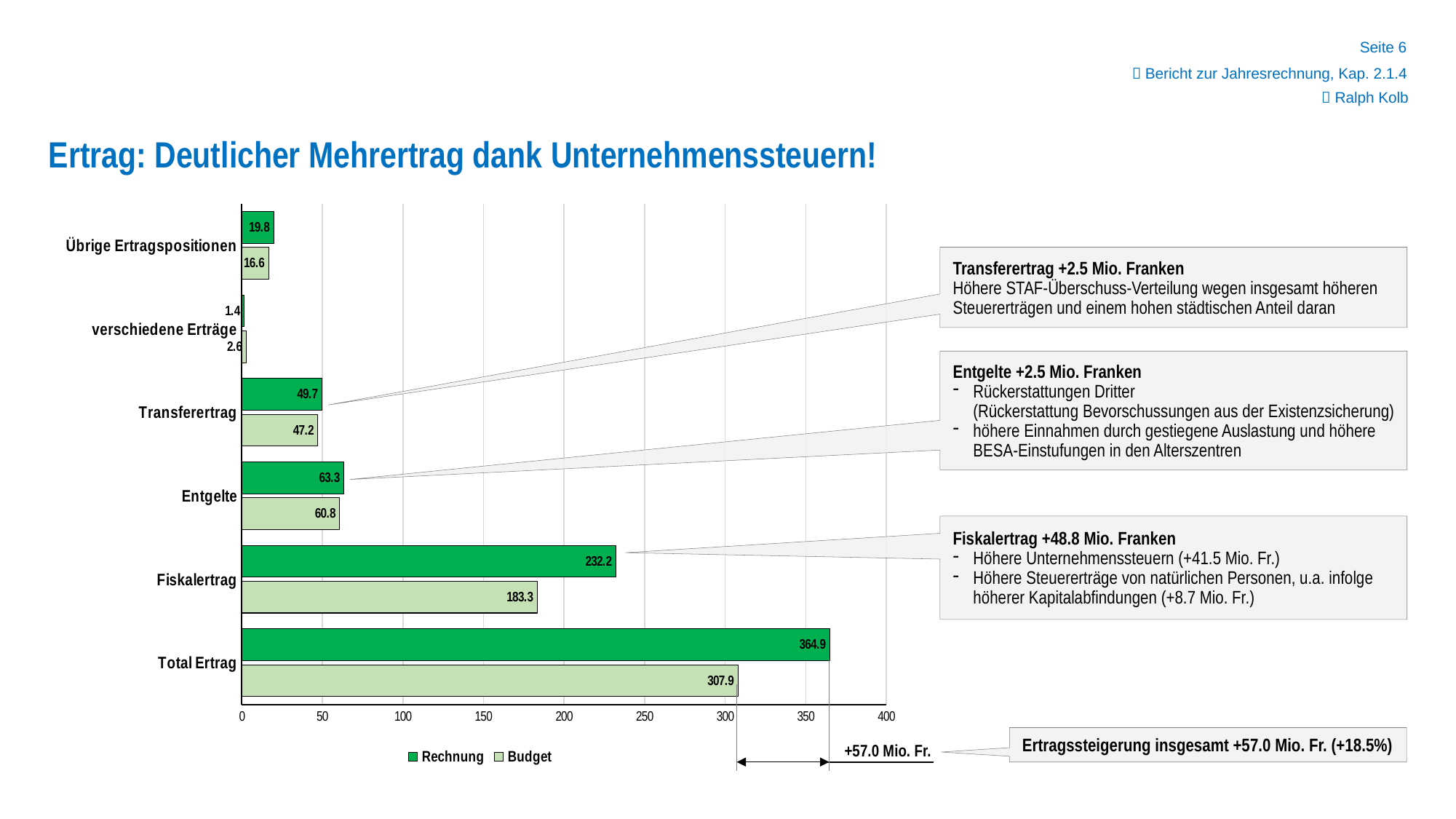
Which category has the lowest Rechnung value? verschiedene Erträge Which is larger for verschiedene Erträge, the Rechnung value or the Budget value? Budget How many categories are shown on the chart? 6 How many series does the legend list? 2 What is the Budget value for Transferertrag? 47.2 Is the Rechnung value for Total Ertrag greater or less than 350? greater Which category has the highest Budget value? Total Ertrag What is the Rechnung value for Fiskalertrag? 232.2 What is the difference between the Rechnung and Budget values for Fiskalertrag? 48.9 What is the Budget value for Total Ertrag? 307.9 What kind of chart is shown on the slide? bar chart What is the Rechnung value for Entgelte? 63.3